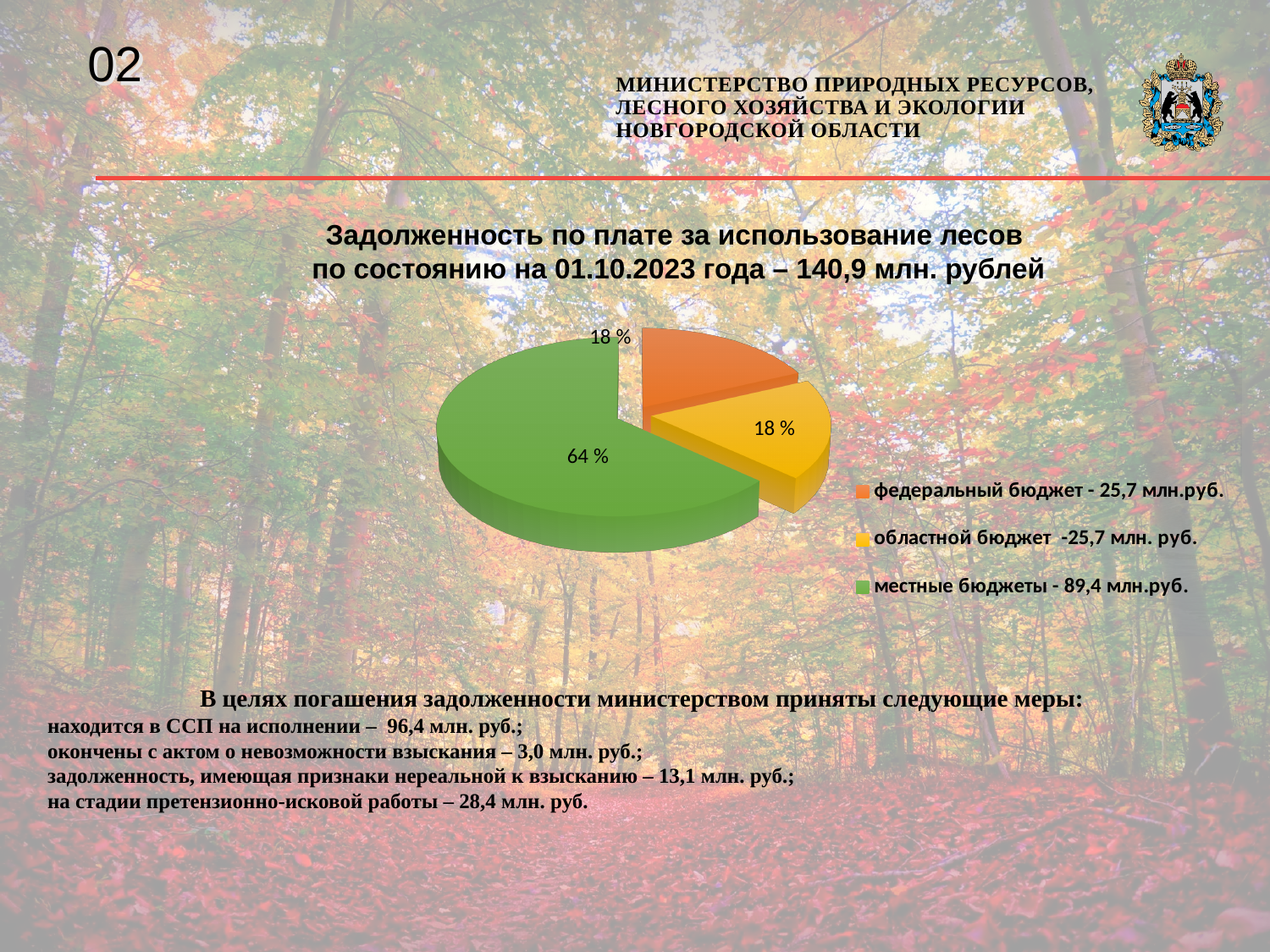
How many entries does the legend of the pie chart list? 3 Which category has the largest slice of the pie? местные бюджеты What colour is the slice for областной бюджет in the pie chart? yellow What share of the pie does the slice for местные бюджеты represent? 64 % What kind of chart is shown on the slide? pie chart What share of the pie does the slice for областной бюджет represent? 18 % Which is larger: the debt for местные бюджеты or for областной бюджет? местные бюджеты What is the difference between the debt for местные бюджеты (89,4 млн.руб.) and for федеральный бюджет (25,7 млн.руб.)? 63,7 млн.руб. What share of the pie does the slice for федеральный бюджет represent? 18 % What is the debt amount for федеральный бюджет according to the legend? 25,7 млн.руб. What is the debt amount for местные бюджеты according to the legend? 89,4 млн.руб. How many slices does the pie chart have? 3